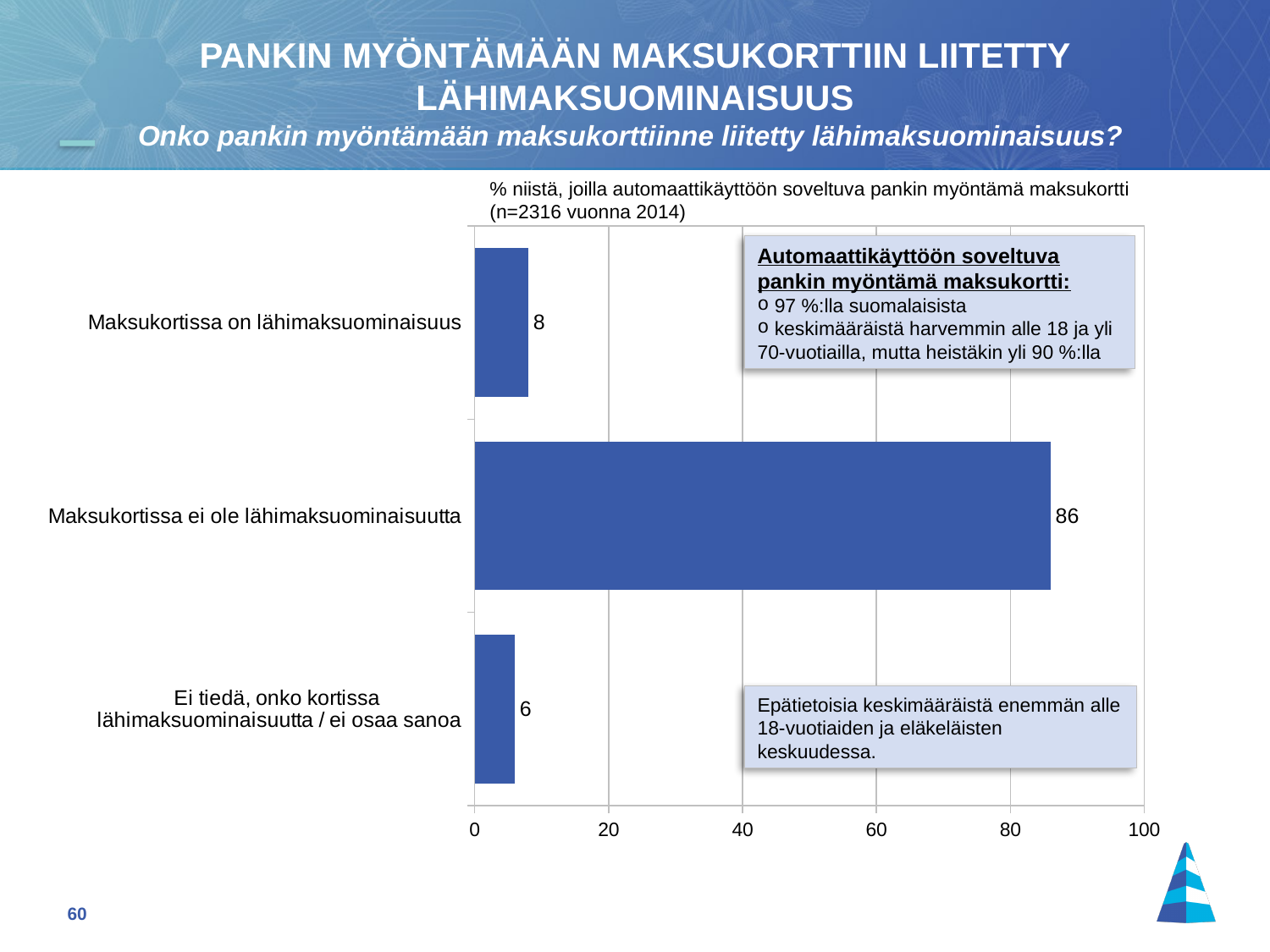
What kind of chart is shown on the slide? bar chart Which category has the highest value? Maksukortissa ei ole lähimaksuominaisuutta How many categories are shown in the chart? 3 What is the difference between the values for "Maksukortissa on lähimaksuominaisuus" and "Ei tiedä, onko kortissa lähimaksuominaisuutta / ei osaa sanoa"? 2 What is the value for "Maksukortissa on lähimaksuominaisuus"? 8 What is the value for "Maksukortissa ei ole lähimaksuominaisuutta"? 86 Which is larger: the value for "Maksukortissa on lähimaksuominaisuus" or for "Ei tiedä, onko kortissa lähimaksuominaisuutta / ei osaa sanoa"? Maksukortissa on lähimaksuominaisuus What is the highest value shown on the x axis of the chart? 100 What is the difference between the values for "Maksukortissa ei ole lähimaksuominaisuutta" and "Maksukortissa on lähimaksuominaisuus"? 78 Is the value for "Maksukortissa ei ole lähimaksuominaisuutta" greater or less than 80? greater Which category has the lowest value? Ei tiedä, onko kortissa lähimaksuominaisuutta / ei osaa sanoa What is the value for "Ei tiedä, onko kortissa lähimaksuominaisuutta / ei osaa sanoa"? 6